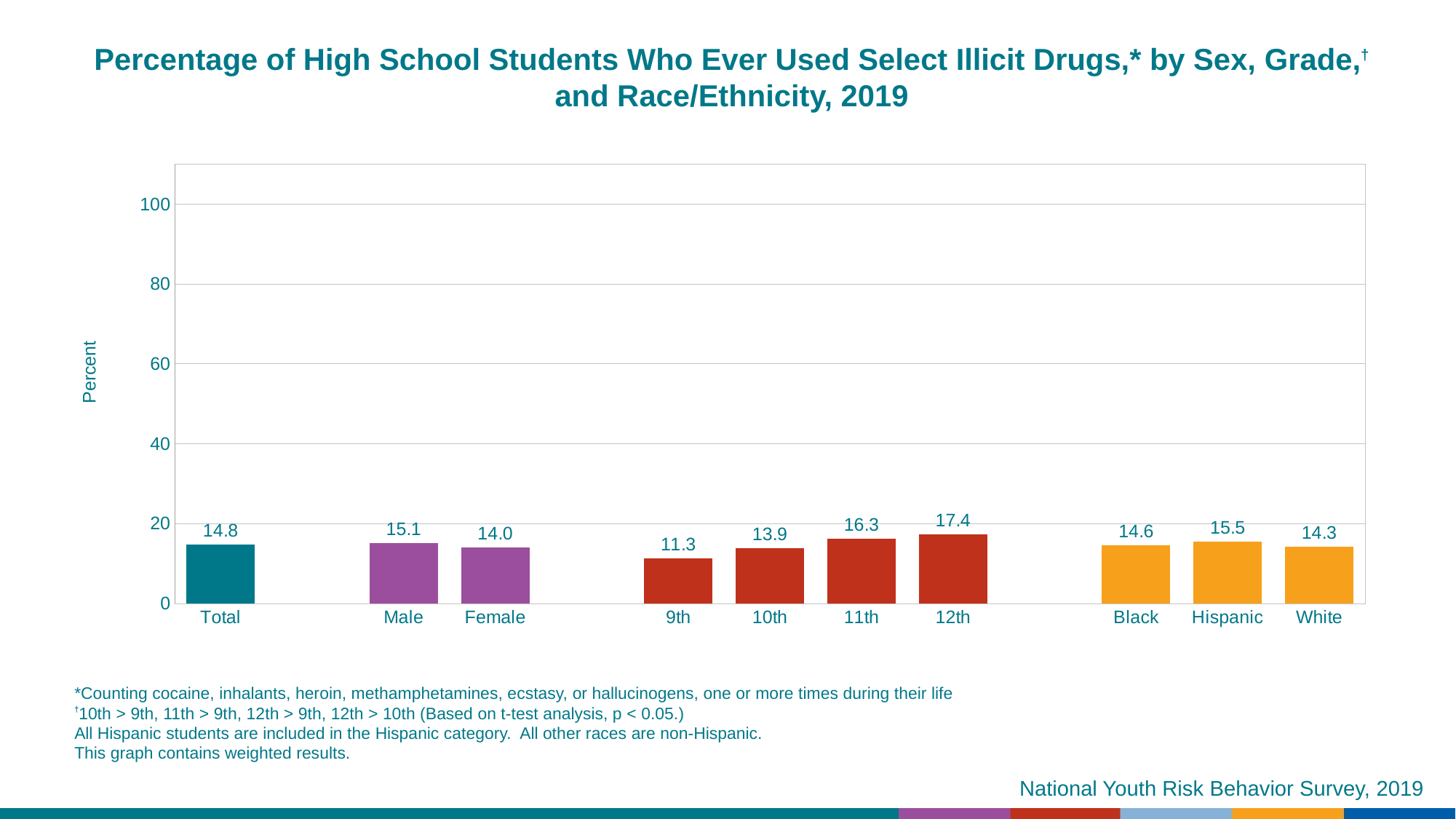
Is the value for 11th grade greater or less than 20? less How many categories are shown on the x axis? 10 Which category has the lowest value? 9th What kind of chart is this? bar chart What is the value for Total? 14.8 Which category has the highest value? 12th What is the difference between the values for 12th and 9th grade? 6.1 What is the value for 12th grade students? 17.4 Which is larger, the value for Hispanic or the value for White? Hispanic Do the values rise or fall from 9th grade to 12th grade? rise What is the difference between the values for Male and Female? 1.1 What is the value for Hispanic students? 15.5